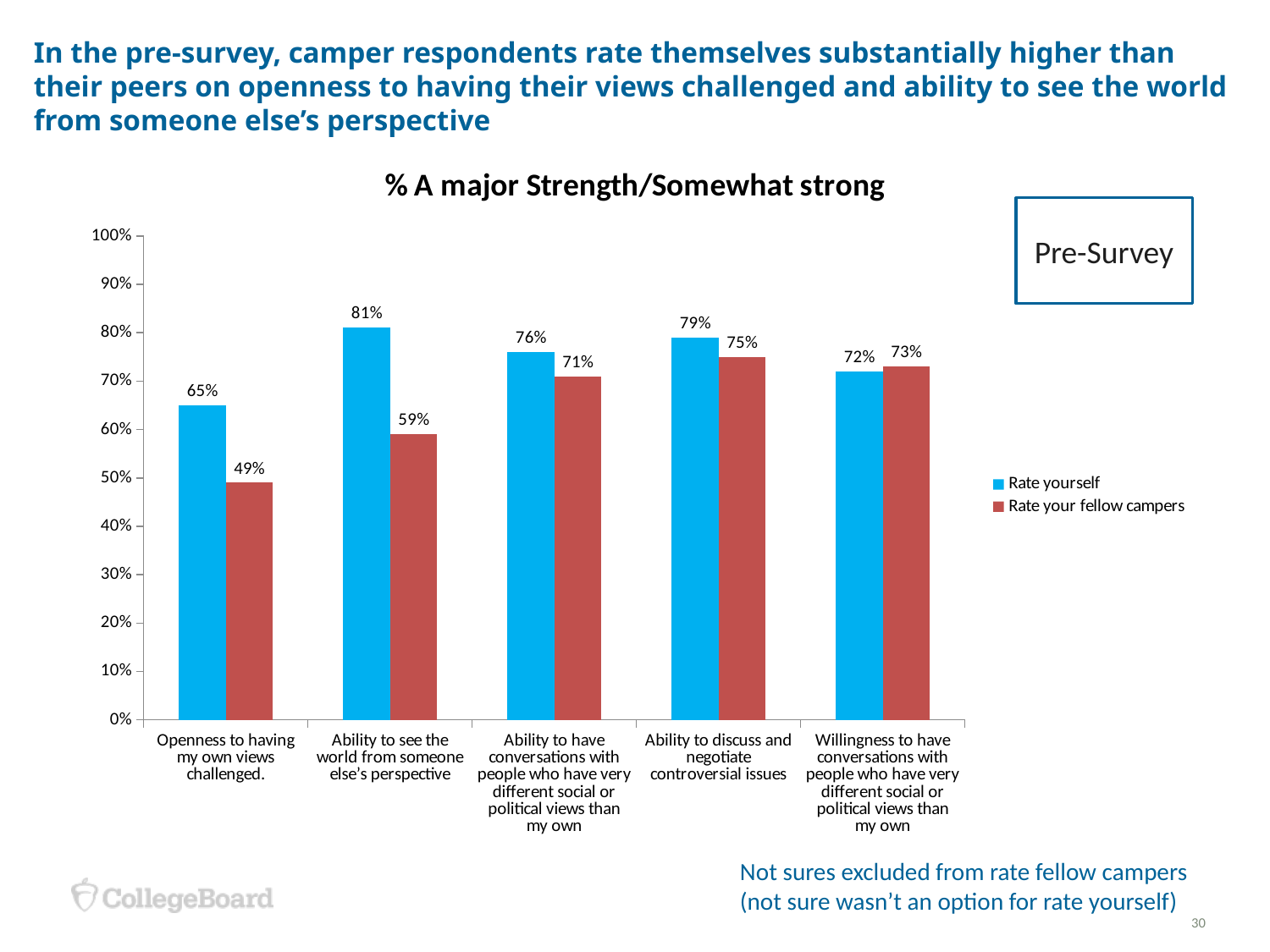
How many series does the legend list? 2 What is the 'Rate your fellow campers' value for 'Ability to see the world from someone else's perspective'? 59% What is the title of the chart? % A major Strength/Somewhat strong What is the 'Rate yourself' value for 'Openness to having my own views challenged.'? 65% What kind of chart is shown on the slide? Bar chart What is the 'Rate your fellow campers' value for 'Ability to discuss and negotiate controversial issues'? 75% What is the difference between the 'Rate yourself' and 'Rate your fellow campers' values for 'Ability to see the world from someone else's perspective'? 22% How many categories are shown on the x axis? 5 Which category has the lowest 'Rate your fellow campers' value? Openness to having my own views challenged. Which category has the highest 'Rate yourself' value? Ability to see the world from someone else's perspective Is the 'Rate yourself' value for 'Ability to have conversations with people who have very different social or political views than my own' greater or less than 70%? greater For 'Willingness to have conversations with people who have very different social or political views than my own', which is larger: 'Rate yourself' or 'Rate your fellow campers'? Rate your fellow campers